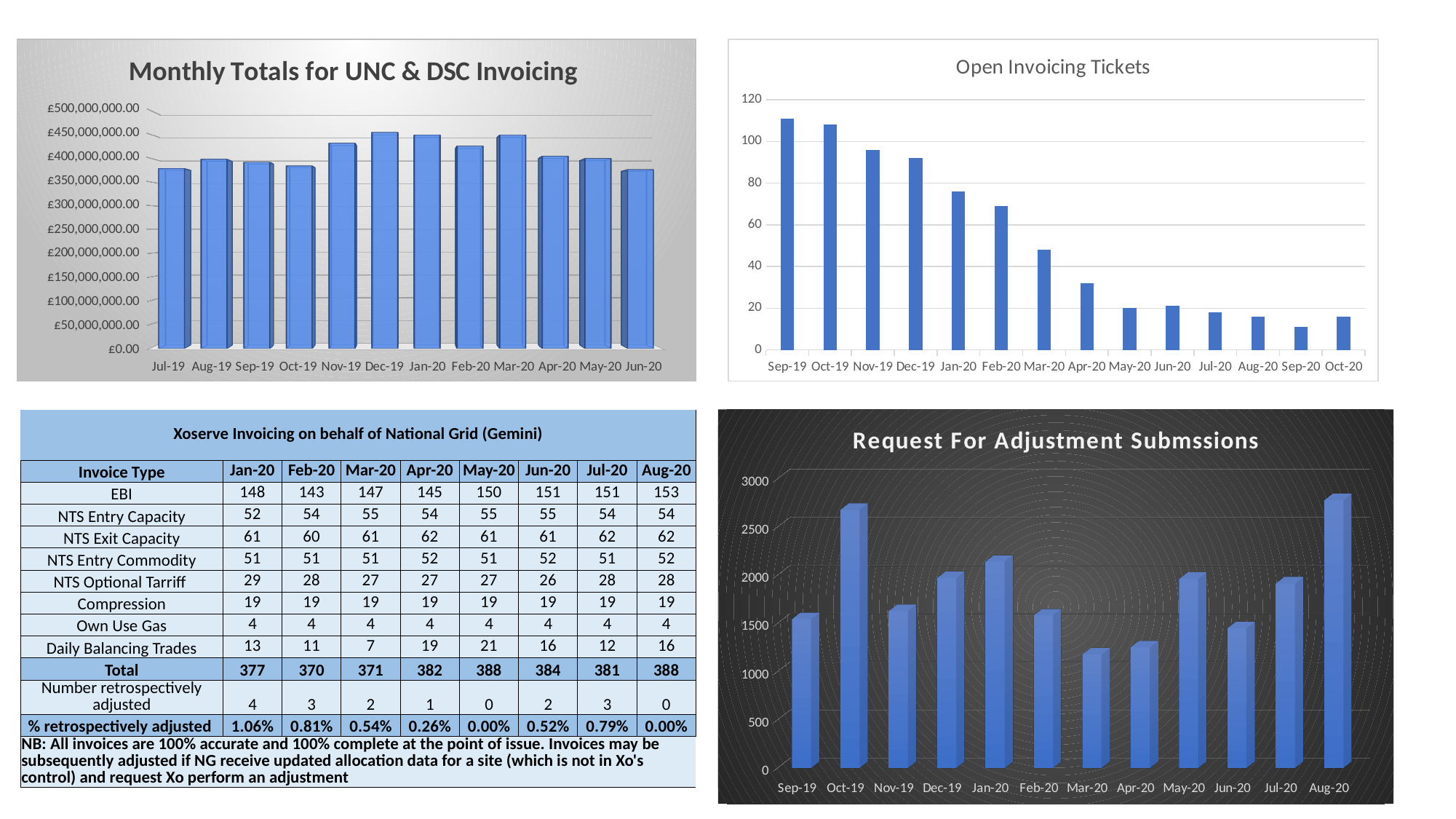
In the "Open Invoicing Tickets" chart, which month has the lowest value? Sep-20 In the "Request For Adjustment Submssions" chart, which is larger, the value for Oct-19 or the value for Jan-20? Oct-19 In the "Open Invoicing Tickets" chart, is the value for Mar-20 greater or less than 60? less In the "Monthly Totals for UNC & DSC Invoicing" chart, is the value for Oct-19 greater or less than £400,000,000.00? less What kind of chart is the "Monthly Totals for UNC & DSC Invoicing" chart? bar chart In the "Open Invoicing Tickets" chart, do the values generally rise or fall from Sep-19 to Oct-20? fall In the "Open Invoicing Tickets" chart, which month has the highest value? Sep-19 How many months are plotted in the "Monthly Totals for UNC & DSC Invoicing" chart? 12 In the "Monthly Totals for UNC & DSC Invoicing" chart, is the value for Dec-19 greater or less than £400,000,000.00? greater In the "Request For Adjustment Submssions" chart, which month has the highest value? Aug-20 How many months are plotted in the "Open Invoicing Tickets" chart? 14